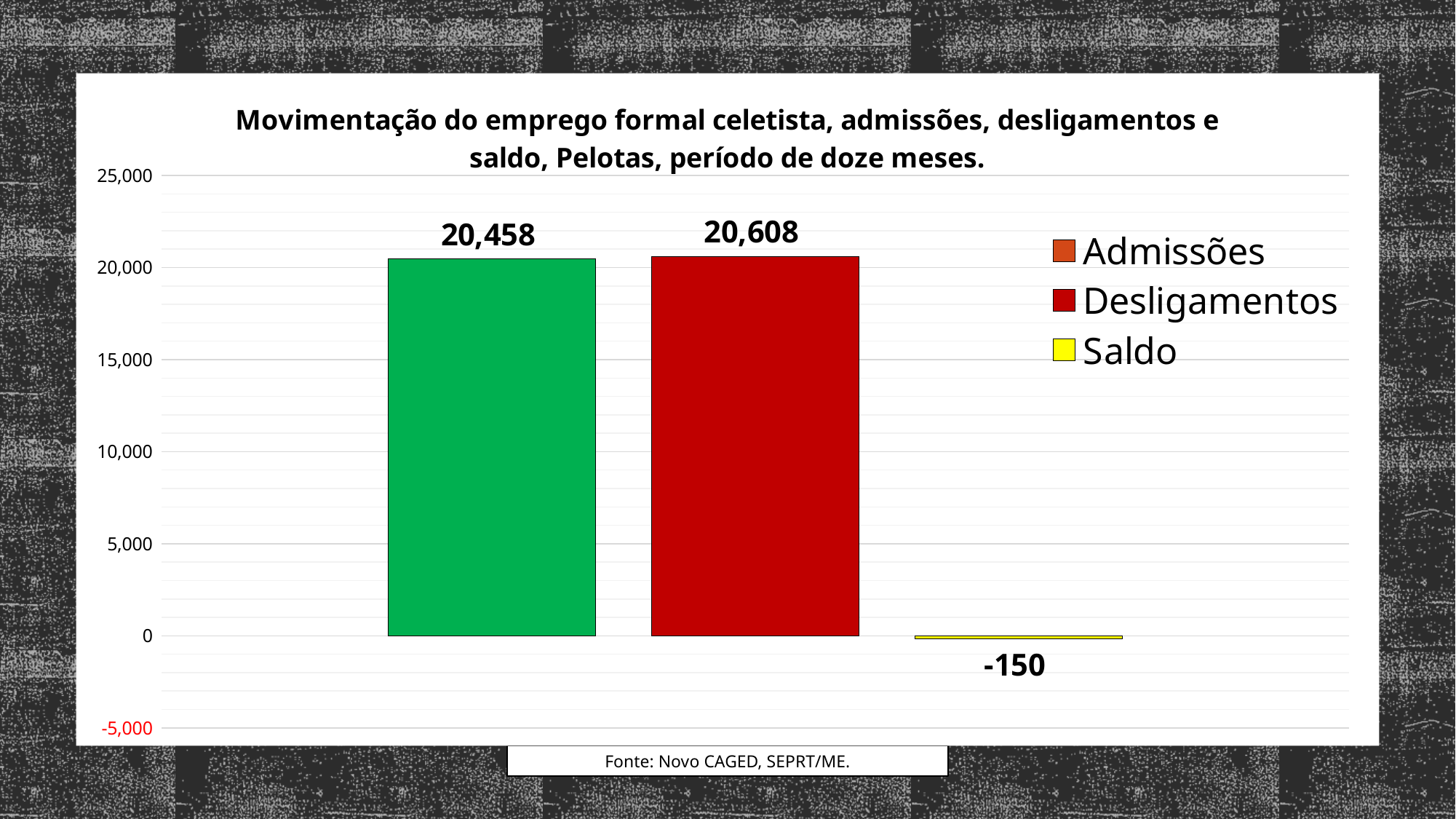
What is the source cited below the chart? Novo CAGED, SEPRT/ME. Is the value for Admissões greater or less than 20,000? greater Which is larger, Admissões or Desligamentos? Desligamentos What is the difference between Desligamentos and Admissões? 150 How many series does the legend list? 3 Which series has the lowest value? Saldo What is the value for Saldo? -150 Which city does the chart title refer to? Pelotas What is the value for Admissões? 20,458 Which series has the highest value? Desligamentos What kind of chart is shown on the slide? bar chart What is the value for Desligamentos? 20,608